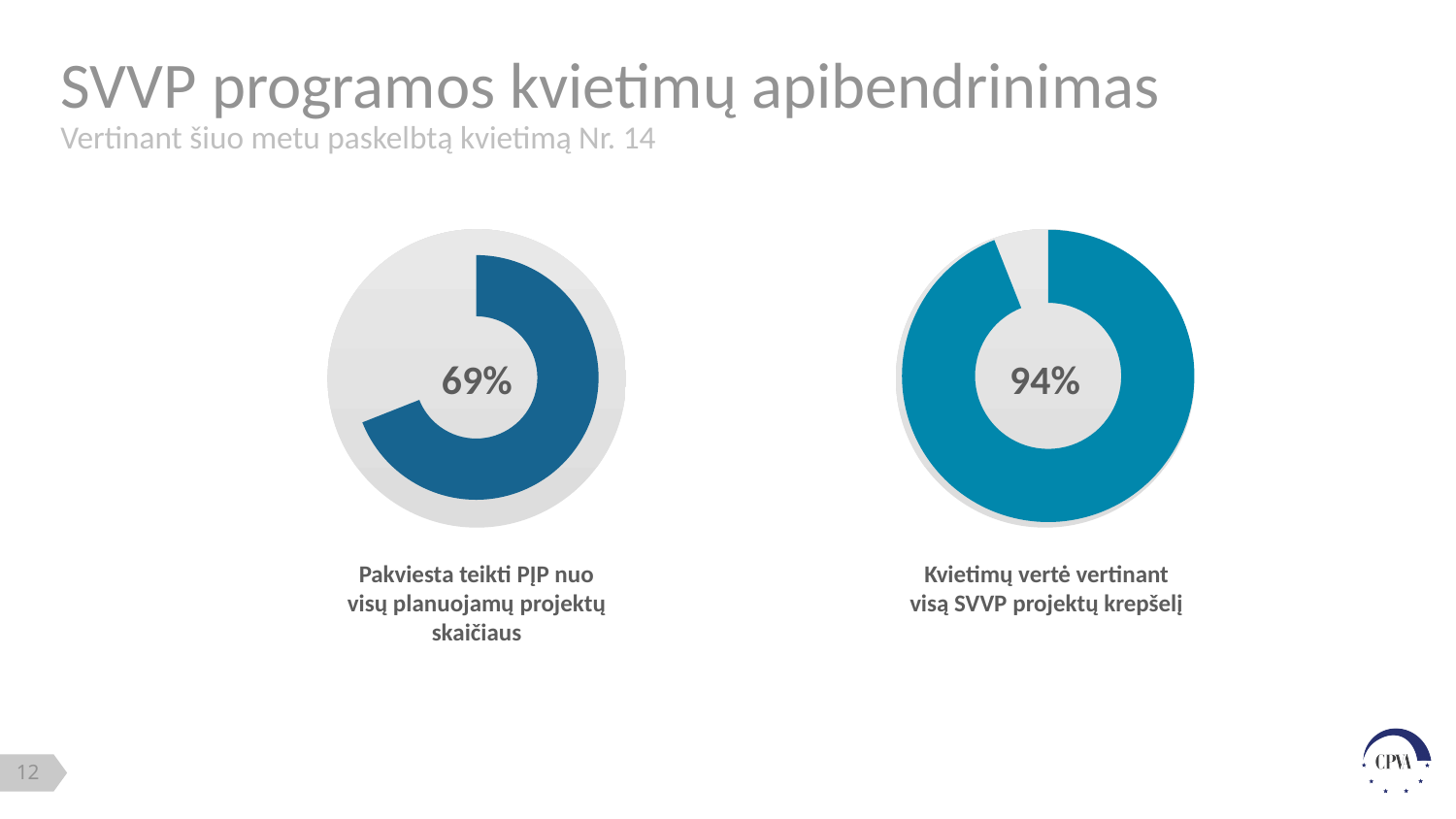
What is the caption under the right donut chart? Kvietimų vertė vertinant visą SVVP projektų krepšelį Is the value in the right donut chart (Kvietimų vertė vertinant visą SVVP projektų krepšelį) greater or less than 90%? greater What is the caption under the left donut chart? Pakviesta teikti PĮP nuo visų planuojamų projektų skaičiaus What percentage is shown in the left donut chart (Pakviesta teikti PĮP nuo visų planuojamų projektų skaičiaus)? 69% What type of chart is used on this slide to show the 69% and 94% values? Donut (pie) chart What percentage is shown in the right donut chart (Kvietimų vertė vertinant visą SVVP projektų krepšelį)? 94% Which chart shows the larger percentage, the left one (69%) or the right one (Kvietimų vertė vertinant visą SVVP projektų krepšelį)? The right one (94%) Which chart has the lowest percentage value on the slide? The left chart (Pakviesta teikti PĮP nuo visų planuojamų projektų skaičiaus), 69% What is the difference in percentage points between the value in the right donut chart and the value in the left donut chart? 25 percentage points How many donut charts are shown on the slide? 2 Is the value in the left donut chart (Pakviesta teikti PĮP nuo visų planuojamų projektų skaičiaus) greater or less than 50%? greater